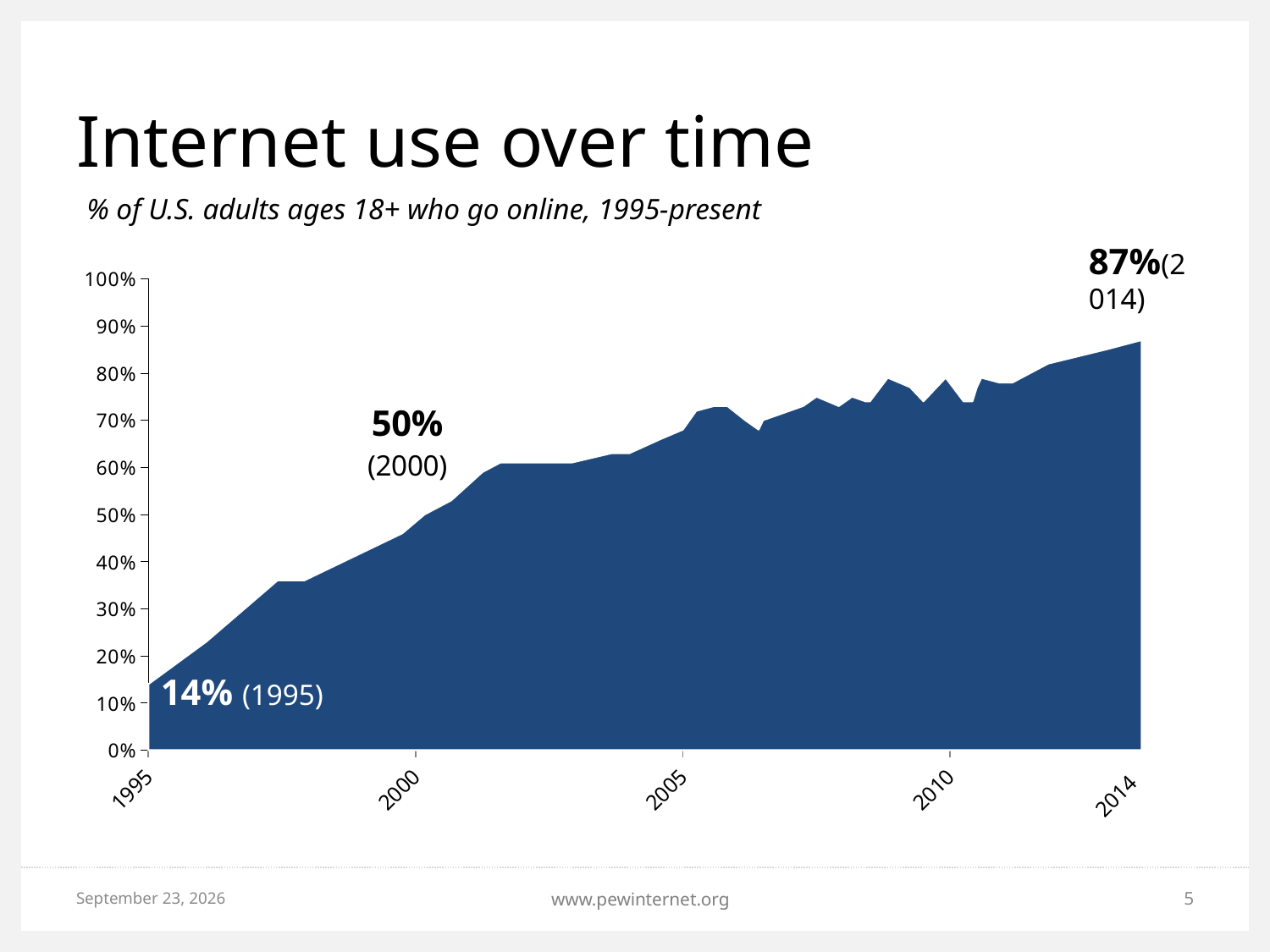
Which year shown has the lowest share of adults going online? 1995 By how many percentage points did internet use increase from 1995 to 2014? 73 percentage points By how many percentage points did internet use increase from 1995 to 2000? 36 percentage points What is the title of the chart on the slide? Internet use over time Is the value for 2005 greater or less than 60%? greater What percentage of U.S. adults went online in 2014, according to the chart? 87% What percentage of U.S. adults went online in 2000, according to the chart? 50% What kind of chart is shown on the slide? Area chart Which year shown has the highest share of adults going online? 2014 Is the value for 2010 greater or less than 70%? greater What percentage of U.S. adults went online in 1995, according to the chart? 14% Does the share of adults going online generally rise or fall from 1995 to 2014? Rise